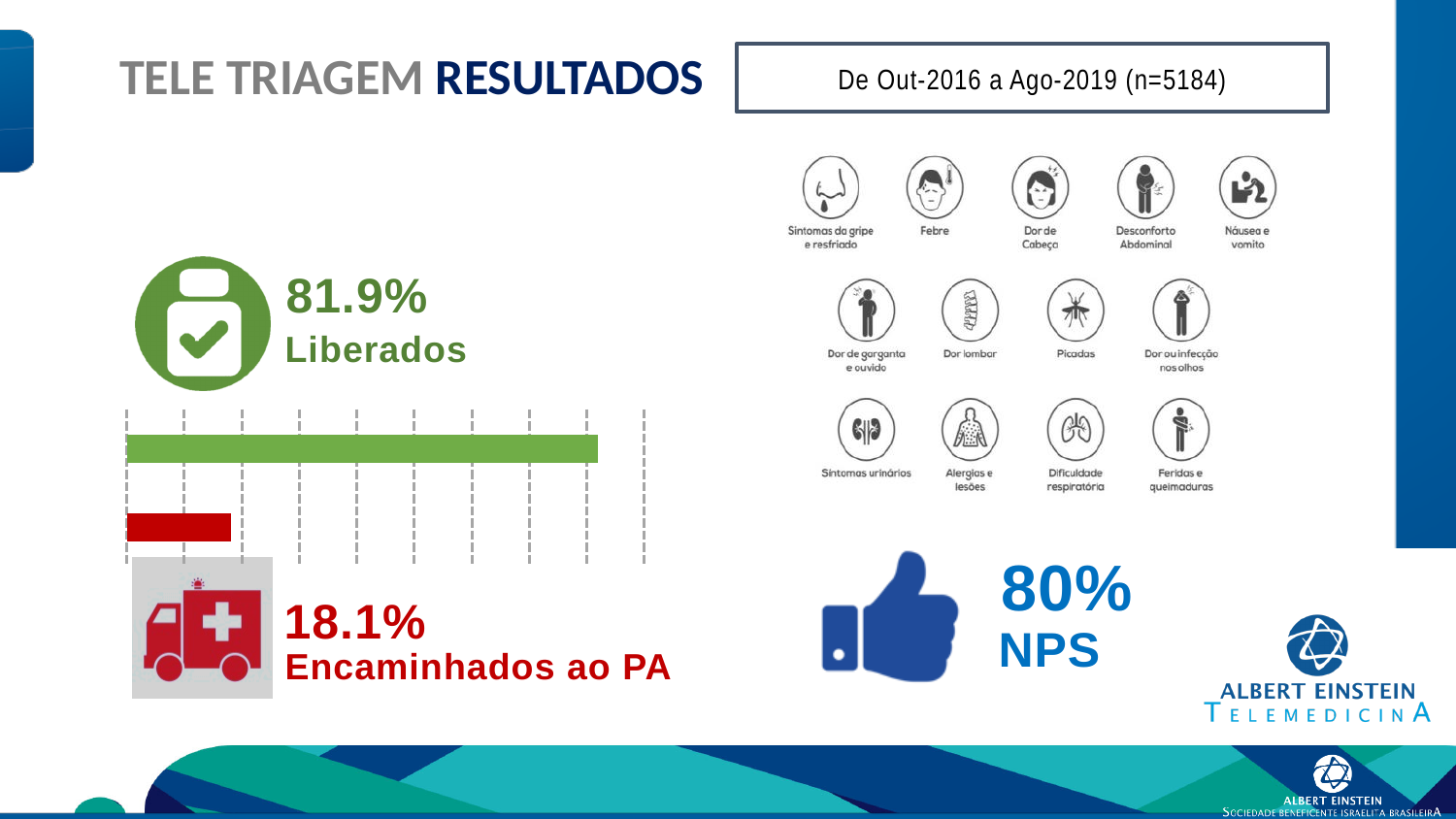
What is the difference in percentage points between Liberados and Encaminhados ao PA? 63.8% How many bars are shown in the chart? 2 What percentage of tele triage patients were 'Liberados' according to the bar chart? 81.9% What colour is the bar for Liberados? green What percentage of patients were 'Encaminhados ao PA' according to the bar chart? 18.1% What kind of chart is used to show the Liberados and Encaminhados ao PA results? bar chart What do the two bar values (Liberados and Encaminhados ao PA) add up to? 100% Is the value for Liberados larger or smaller than the value for Encaminhados ao PA? larger Which category has the shortest bar in the chart? Encaminhados ao PA What colour is the bar for Encaminhados ao PA? red Which category has the longer bar in the chart, Liberados or Encaminhados ao PA? Liberados